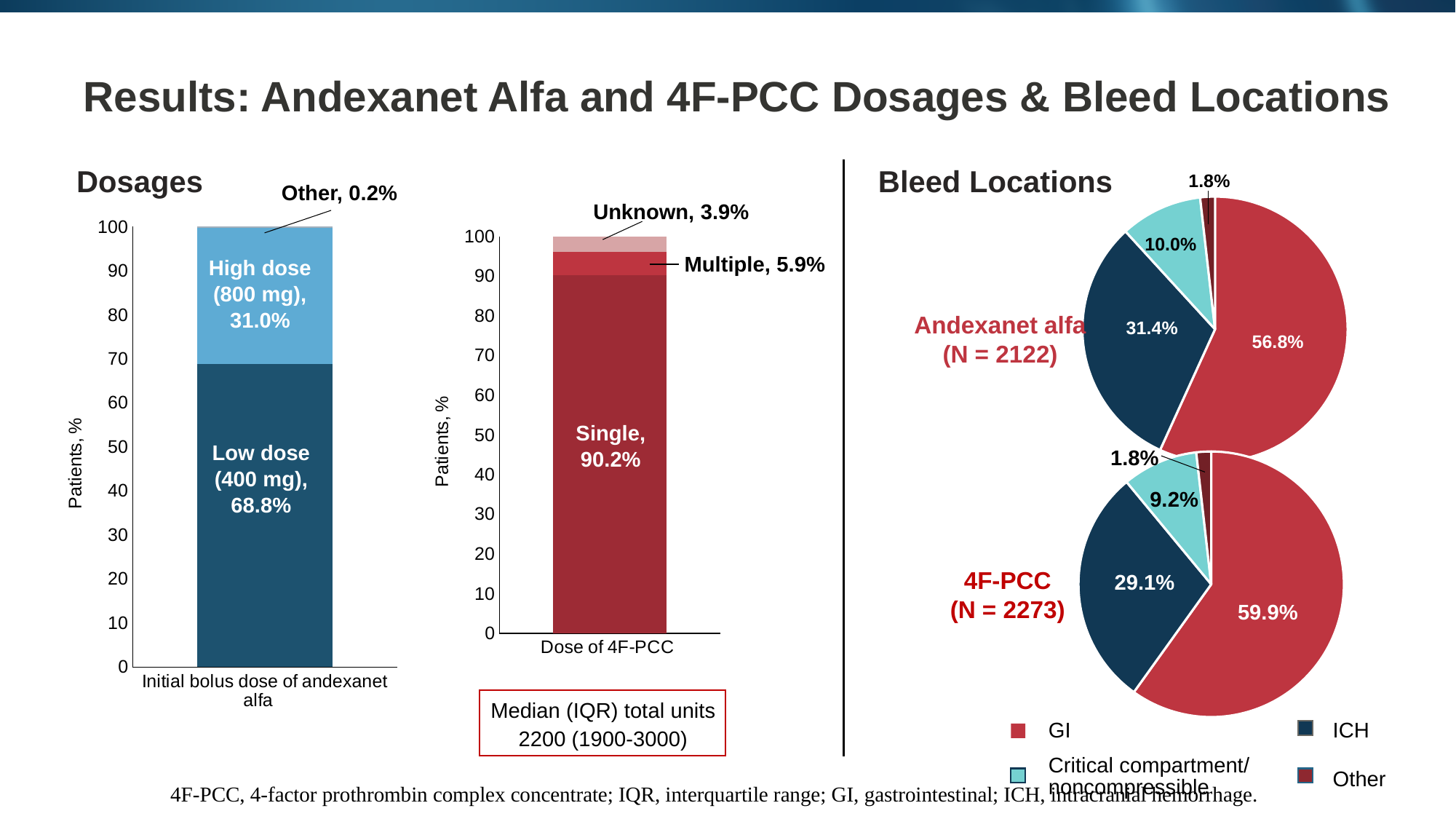
In the 4F-PCC dosage bar chart, which segment is the smallest? Unknown What kind of chart is used to show the dosages on the left side of the slide? Stacked bar chart Which is larger: the critical compartment/noncompressible share in the Andexanet alfa pie chart or in the 4F-PCC pie chart? Andexanet alfa In the 4F-PCC dosage bar chart, what percentage of patients received a single dose? 90.2% In the andexanet alfa dosage bar chart, what percentage of patients received the low dose (400 mg)? 68.8% In the 4F-PCC (N = 2273) pie chart, which bleed location has the largest share? GI In the andexanet alfa dosage bar chart, what percentage of patients received the high dose (800 mg)? 31.0% In the 4F-PCC dosage bar chart, what is the difference between the 'Multiple' and 'Unknown' percentages? 2.0% How many bleed location categories does the legend for the pie charts list? 4 In the Andexanet alfa (N = 2122) pie chart, what share of bleeds were GI? 56.8% In the 4F-PCC (N = 2273) pie chart, what share of bleeds were ICH? 29.1% In the andexanet alfa dosage bar chart, what percentage is labelled 'Other'? 0.2%